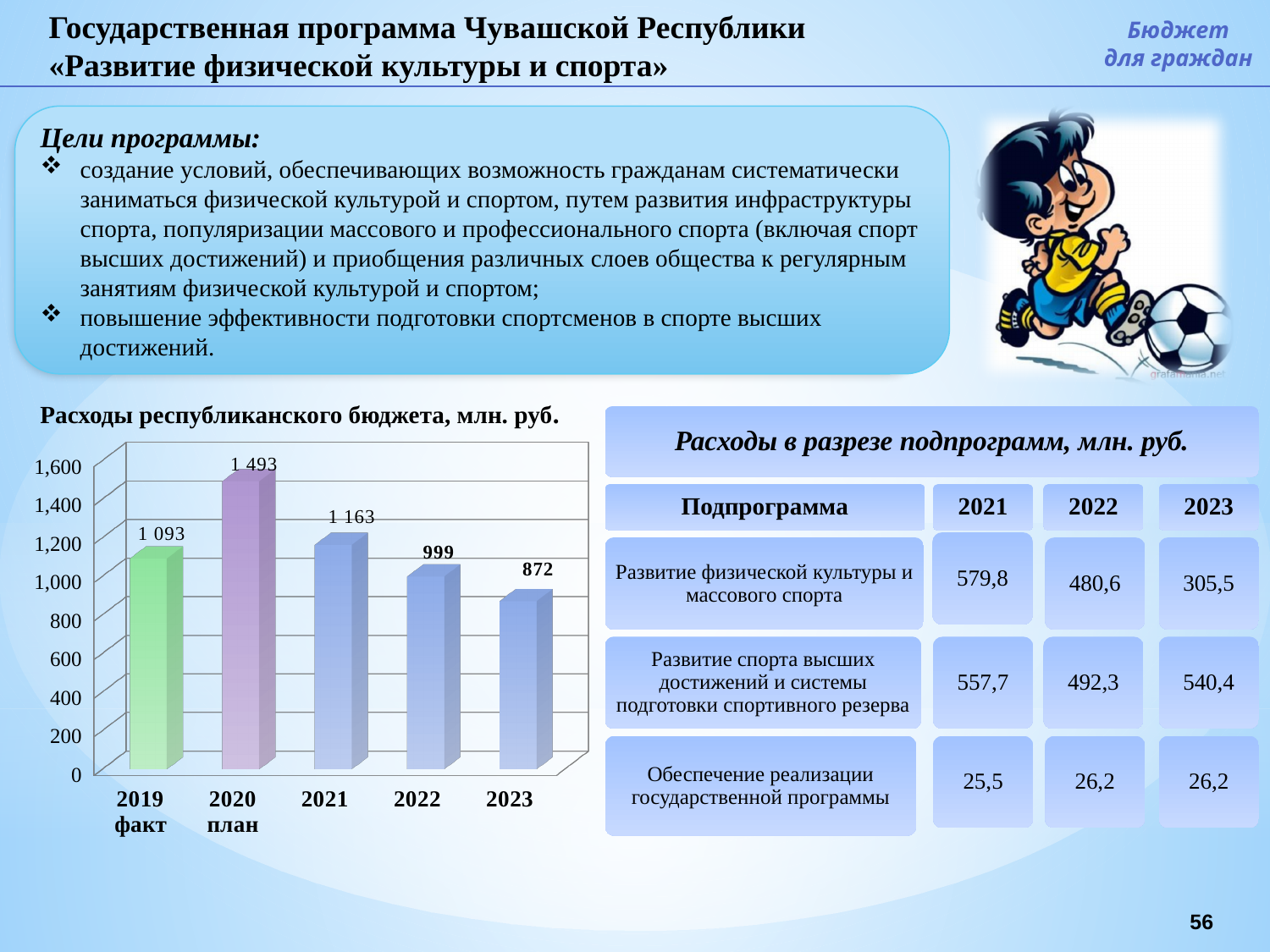
What is the difference between the values for 2020 план and 2021 in the chart 'Расходы республиканского бюджета, млн. руб.'? 330 What is the difference between the values for 2022 and 2023 in the chart 'Расходы республиканского бюджета, млн. руб.'? 127 Do the values in the chart 'Расходы республиканского бюджета, млн. руб.' rise or fall from 2020 план to 2023? fall What kind of chart is 'Расходы республиканского бюджета, млн. руб.'? bar chart Which year has the lowest value in the chart 'Расходы республиканского бюджета, млн. руб.'? 2023 What is the value for 2019 факт in the chart 'Расходы республиканского бюджета, млн. руб.'? 1 093 How many bars are shown in the chart 'Расходы республиканского бюджета, млн. руб.'? 5 What is the value for 2020 план in the chart 'Расходы республиканского бюджета, млн. руб.'? 1 493 What is the value for 2023 in the chart 'Расходы республиканского бюджета, млн. руб.'? 872 Which year has the highest value in the chart 'Расходы республиканского бюджета, млн. руб.'? 2020 план What is the value for 2022 in the chart 'Расходы республиканского бюджета, млн. руб.'? 999 Which is larger in the chart 'Расходы республиканского бюджета, млн. руб.': the value for 2019 факт or the value for 2021? 2021